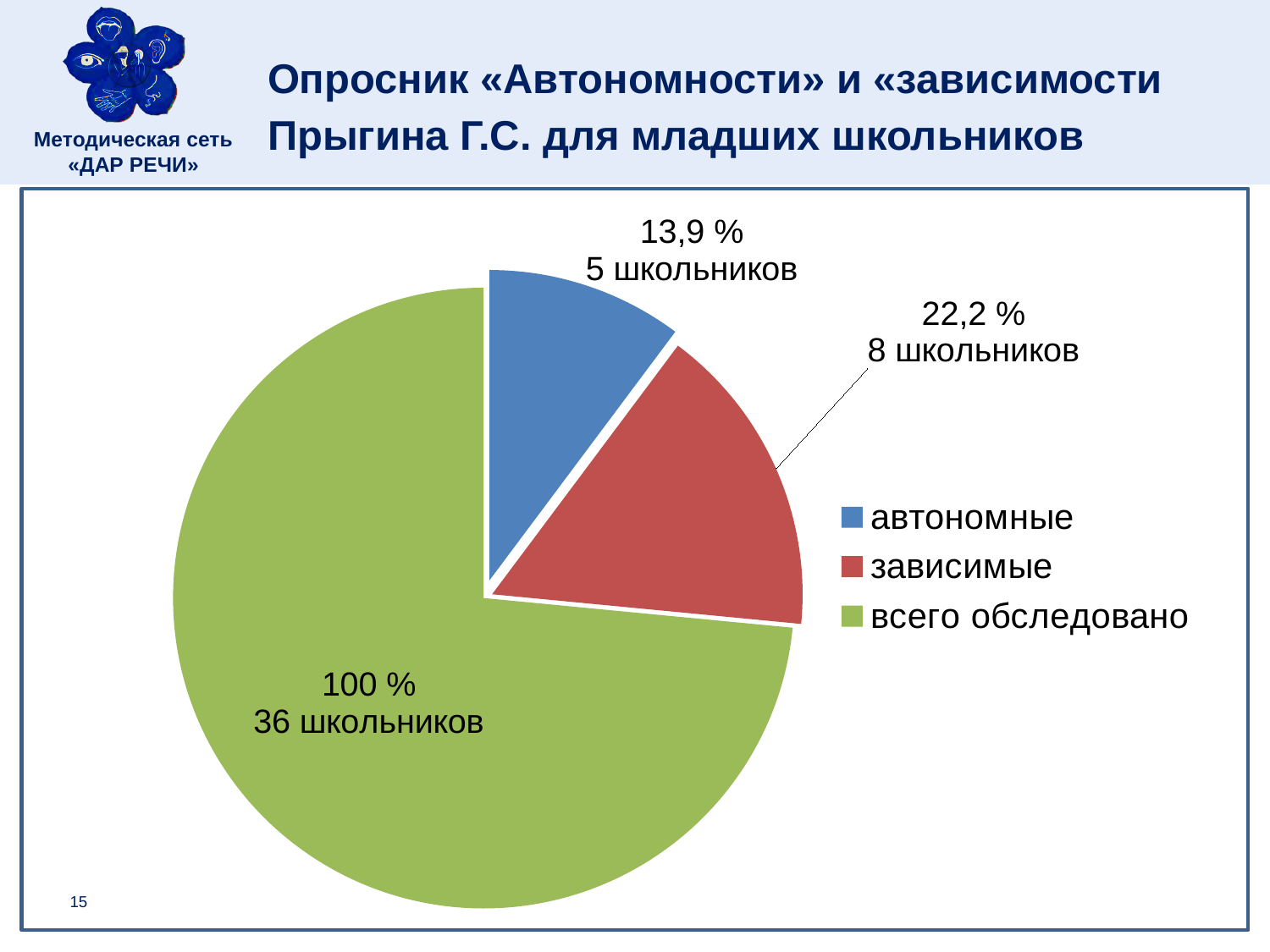
How many schoolchildren are shown on the label for the «всего обследовано» slice? 36 школьников How many schoolchildren are shown on the label for the «зависимые» slice? 8 школьников How many entries does the legend of the pie chart list? 3 How many schoolchildren are shown on the label for the «автономные» slice? 5 школьников Which slice is larger, «автономные» or «зависимые»? зависимые Which slice of the pie chart is the smallest? автономные How many slices does the pie chart have? 3 What percentage is printed on the label for the «автономные» slice? 13,9 % What colour is the «всего обследовано» slice in the pie chart? green Which slice of the pie chart is the largest? всего обследовано What kind of chart is shown on the slide? pie chart What percentage is printed on the label for the «зависимые» slice? 22,2 %